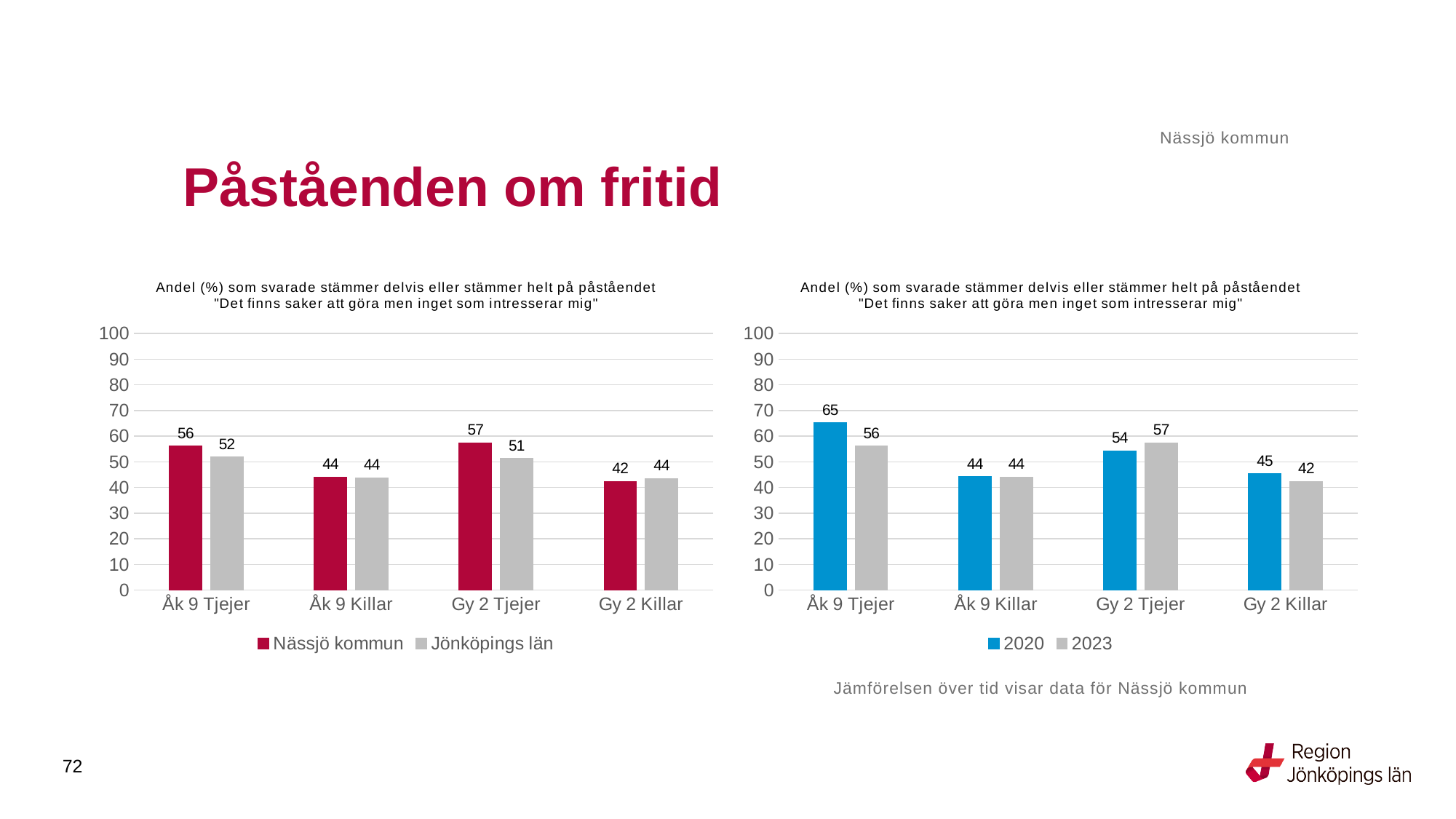
What kind of chart is the right chart (2020 vs 2023)? Bar chart In the right chart (2020 vs 2023), which is larger for Gy 2 Tjejer: 2020 or 2023? 2023 In the left chart (Nässjö kommun vs Jönköpings län), which category has the highest value for Nässjö kommun? Gy 2 Tjejer In the right chart (2020 vs 2023), what is the value for 2020 for Åk 9 Tjejer? 65 In the left chart (Nässjö kommun vs Jönköpings län), what is the difference between Nässjö kommun and Jönköpings län for Gy 2 Tjejer? 6 In the left chart (Nässjö kommun vs Jönköpings län), which category has the lowest value for Nässjö kommun? Gy 2 Killar In the right chart (2020 vs 2023), what is the difference between 2020 and 2023 for Åk 9 Tjejer? 9 In the right chart (2020 vs 2023), what is the value for 2023 for Gy 2 Killar? 42 In the left chart (Nässjö kommun vs Jönköpings län), what is the value for Jönköpings län for Gy 2 Tjejer? 51 In the left chart (Nässjö kommun vs Jönköpings län), how many series does the legend list? 2 In the right chart (2020 vs 2023), which category has the highest value for 2020? Åk 9 Tjejer In the left chart (Nässjö kommun vs Jönköpings län), what is the value for Nässjö kommun for Åk 9 Tjejer? 56